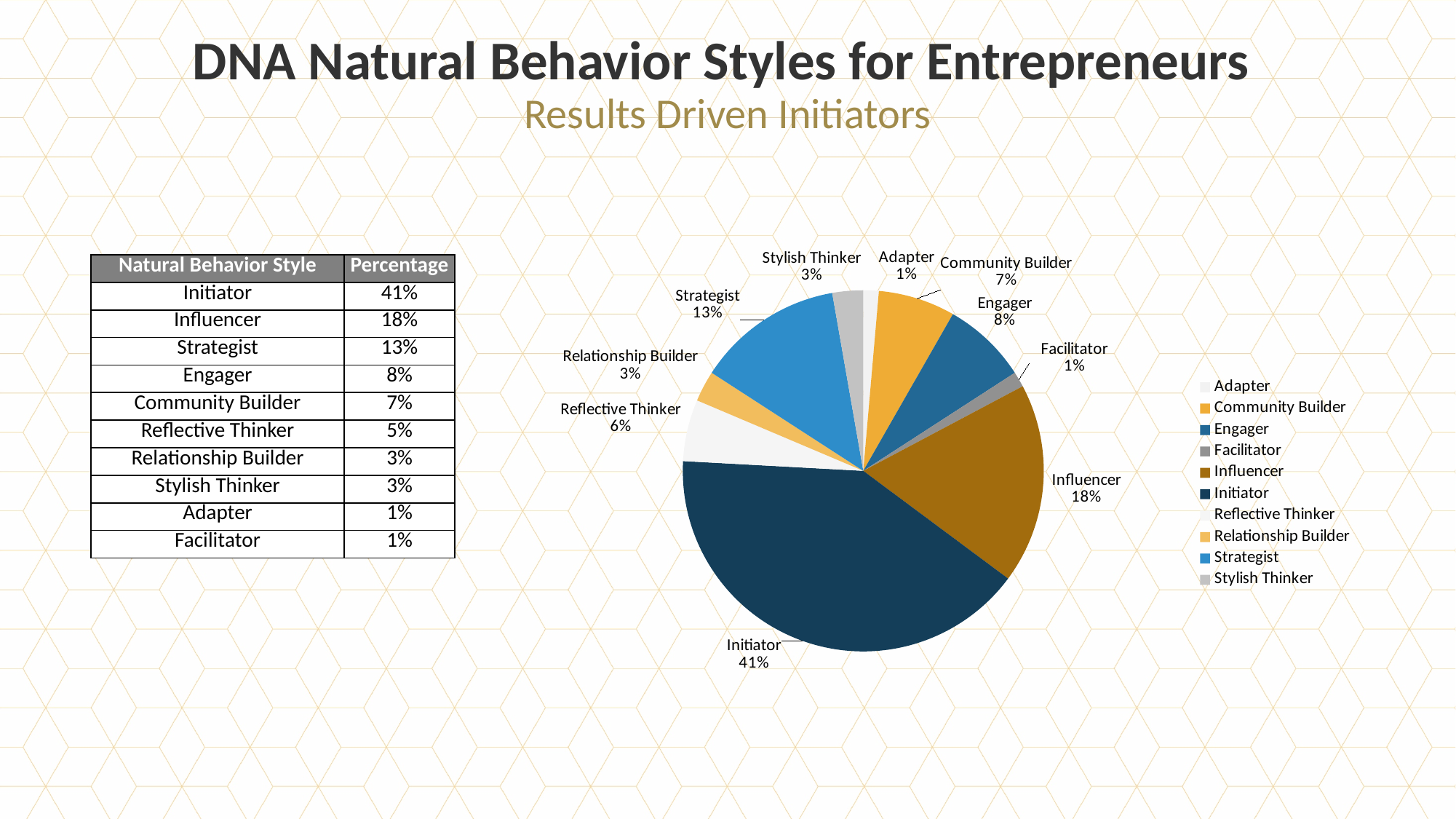
What is the difference between the Initiator and Influencer percentages in the pie chart? 23% In the pie chart, what percentage is shown for Strategist? 13% What is the subtitle shown below the main title of the slide? Results Driven Initiators What kind of chart is shown on the slide? pie chart Which slice of the pie chart is the largest? Initiator How many slices does the pie chart have? 10 In the pie chart, what percentage is shown for Engager? 8% Which is larger in the pie chart, Strategist or Engager? Strategist In the pie chart, what percentage is shown for Community Builder? 7% How many entries does the pie chart's legend list? 10 What is the difference between the Influencer and Strategist percentages in the pie chart? 5% In the pie chart, what percentage is shown for Initiator? 41%